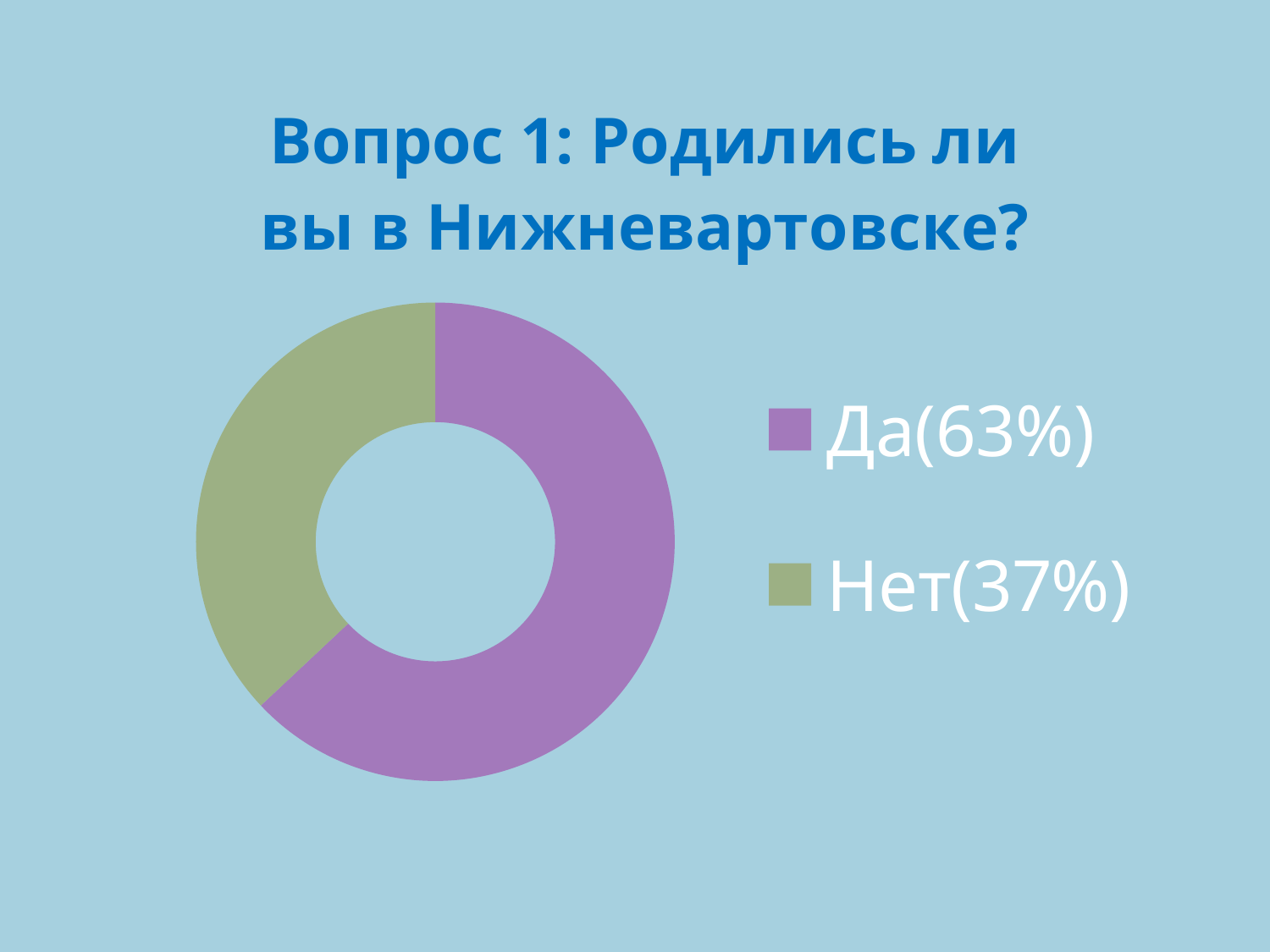
What share of respondents answered "Нет" (No)? 37% What kind of chart is shown on the slide? Doughnut (pie) chart Which is larger, the share for "Да" or the share for "Нет"? Да Do the two shares shown in the legend add up to 100%? Yes What share of respondents answered "Да" (Yes)? 63% What colour represents the "Нет" category in the chart? Green Which answer has the largest share of the chart? Да What is the title of the slide? Вопрос 1: Родились ли вы в Нижневартовске? Which answer has the smallest share of the chart? Нет What is the difference in percentage points between the "Да" and "Нет" shares? 26 How many categories does the chart show? 2